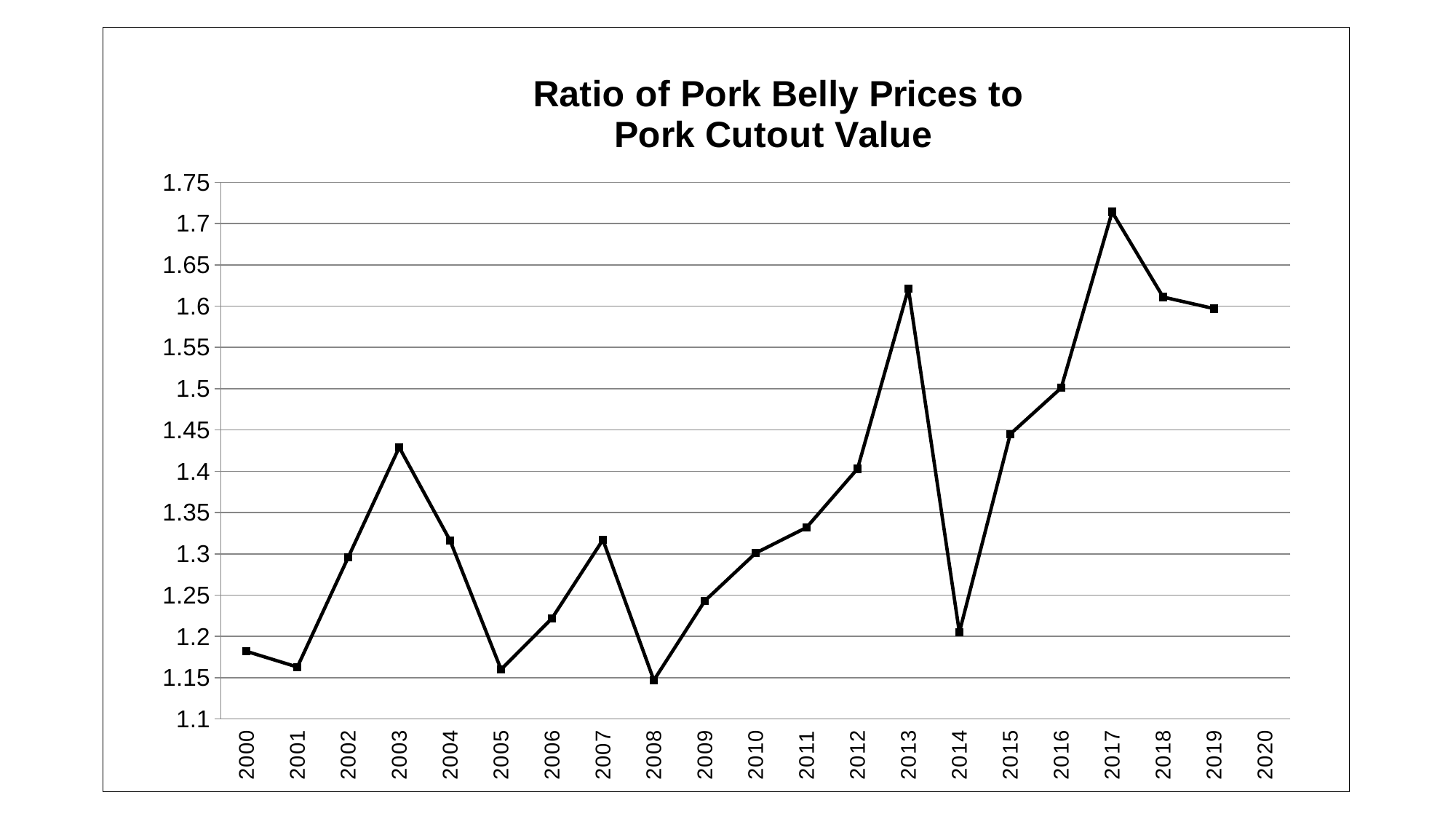
Does the ratio rise or fall from 2003 to 2005? fall In which year is the ratio lowest? 2008 Which year has the higher ratio, 2003 or 2013? 2013 Is the value for 2003 greater or less than 1.4? greater Which year has the higher ratio, 2000 or 2001? 2000 What is the title of the chart? Ratio of Pork Belly Prices to Pork Cutout Value Is the value for 2001 greater or less than 1.2? less In which year is the ratio highest? 2017 Is the value for 2013 greater or less than 1.6? greater Does the ratio rise or fall from 2014 to 2017? rise What kind of chart is shown on the slide? line chart